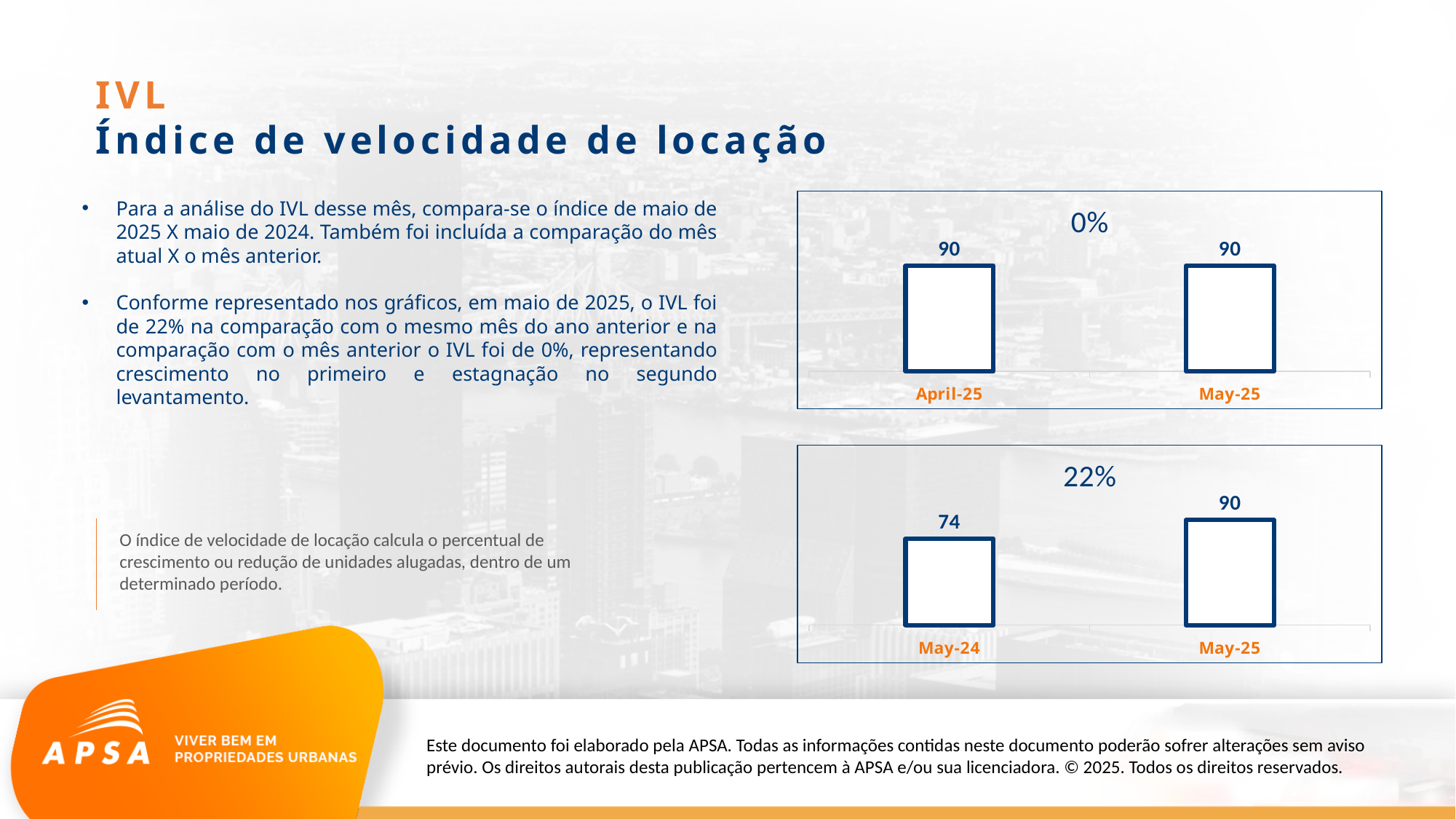
In the top chart, what is the value for May-25? 90 In the bottom chart, what is the value for May-24? 74 In the bottom chart, which category has the highest value? May-25 What type of chart is the bottom chart? bar chart What percentage change is displayed above the bars in the bottom chart? 22% In the bottom chart, what is the value for May-25? 90 In the top chart, what is the value for April-25? 90 In the bottom chart, which category has the lowest value? May-24 What percentage change is displayed above the bars in the top chart? 0% In the bottom chart, is the value for May-25 larger or smaller than the value for May-24? larger In the bottom chart, what is the difference between the May-25 and May-24 values? 16 How many bars are shown in the top chart? 2